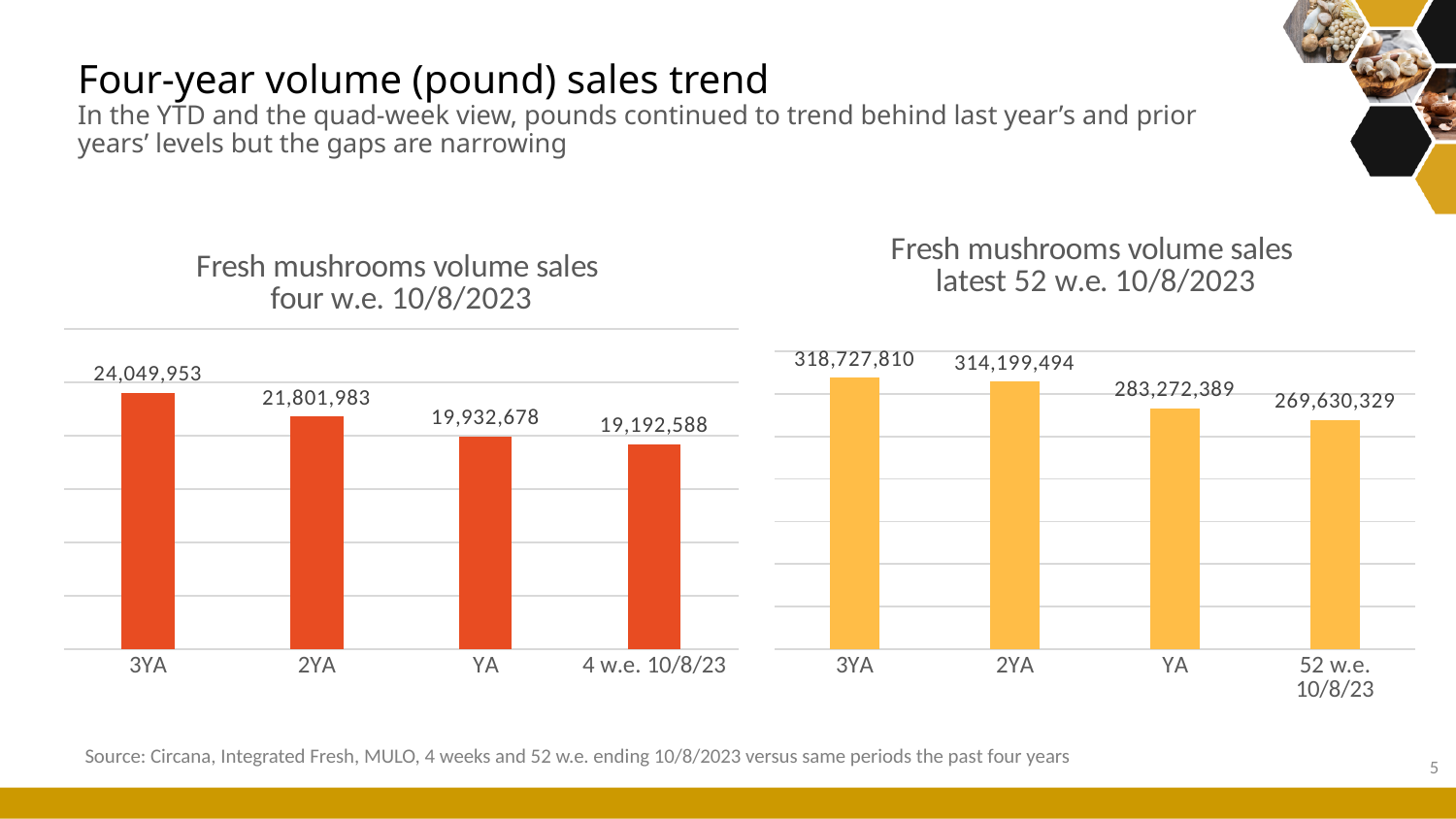
In the 'Fresh mushrooms volume sales four w.e. 10/8/2023' chart, which is larger, the value for 2YA or the value for YA? 2YA In the 'Fresh mushrooms volume sales latest 52 w.e. 10/8/2023' chart, which category has the lowest value? 52 w.e. 10/8/23 In the 'Fresh mushrooms volume sales latest 52 w.e. 10/8/2023' chart, what is the value for YA? 283,272,389 In the 'Fresh mushrooms volume sales latest 52 w.e. 10/8/2023' chart, what is the difference between the YA value and the 52 w.e. 10/8/23 value? 13,642,060 In the 'Fresh mushrooms volume sales four w.e. 10/8/2023' chart, what is the difference between the 3YA value and the 4 w.e. 10/8/23 value? 4,857,365 What type of chart is the 'Fresh mushrooms volume sales four w.e. 10/8/2023' chart? Bar chart How many categories are shown in the 'Fresh mushrooms volume sales latest 52 w.e. 10/8/2023' chart? 4 In the 'Fresh mushrooms volume sales four w.e. 10/8/2023' chart, what is the value for 3YA? 24,049,953 In the 'Fresh mushrooms volume sales latest 52 w.e. 10/8/2023' chart, what is the value for 52 w.e. 10/8/23? 269,630,329 In the 'Fresh mushrooms volume sales four w.e. 10/8/2023' chart, what is the value for 4 w.e. 10/8/23? 19,192,588 In the 'Fresh mushrooms volume sales four w.e. 10/8/2023' chart, which category has the highest value? 3YA In the 'Fresh mushrooms volume sales latest 52 w.e. 10/8/2023' chart, do the values rise or fall from 3YA to 52 w.e. 10/8/23? Fall